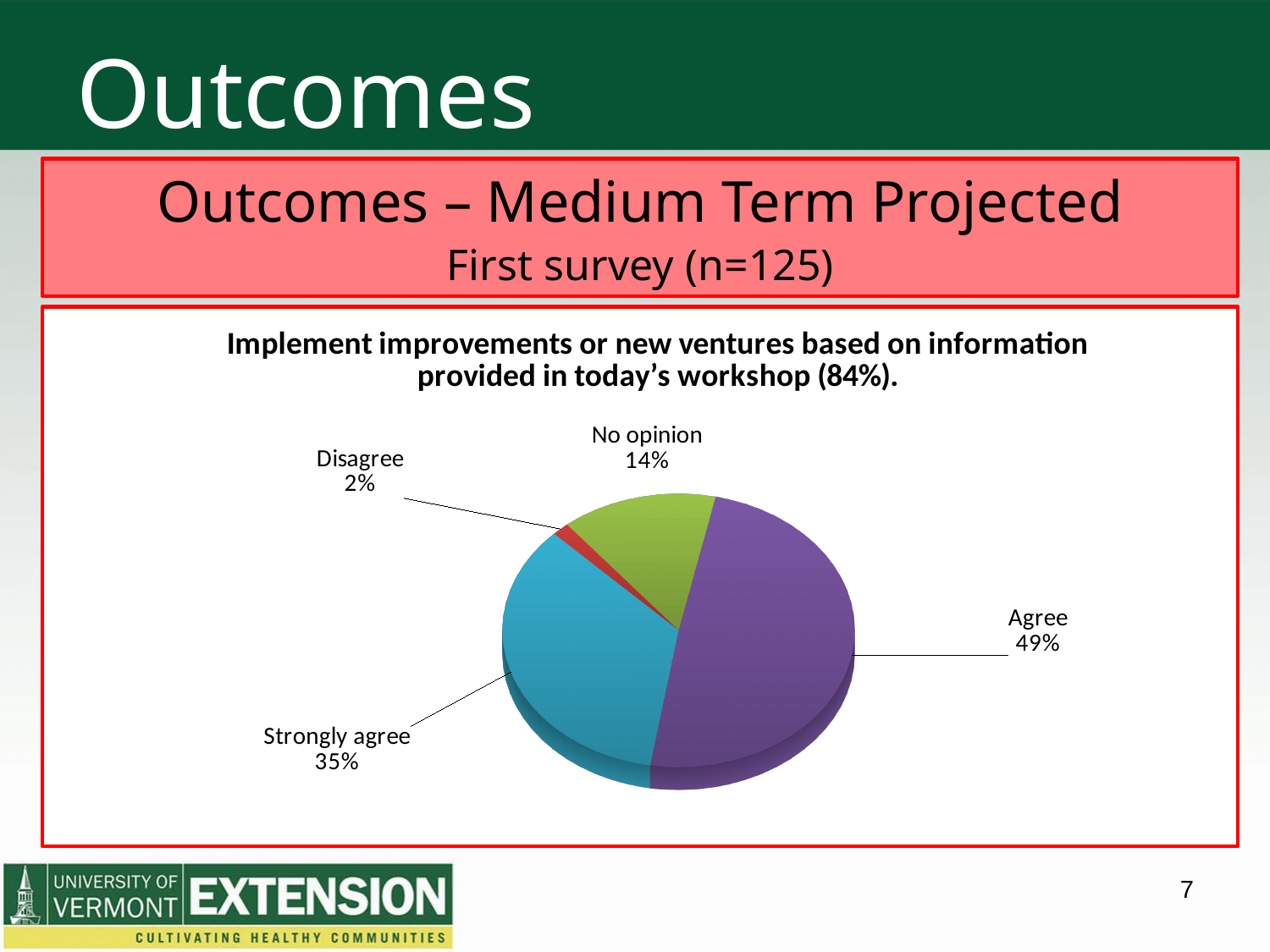
What percentage of respondents chose "Agree"? 49% What is the combined share of "Agree" and "Strongly agree"? 84% Which response category has the largest share of the pie? Agree What kind of chart is shown on the slide? Pie chart How many response categories are shown in the pie chart? 4 Which is larger, the share for "No opinion" or the share for "Strongly agree"? Strongly agree What percentage of respondents chose "Strongly agree"? 35% Which response category has the smallest share of the pie? Disagree What colour is the "Agree" slice of the pie? Purple What percentage of respondents chose "Disagree"? 2% What percentage of respondents chose "No opinion"? 14% What is the difference in percentage points between "Agree" and "Strongly agree"? 14